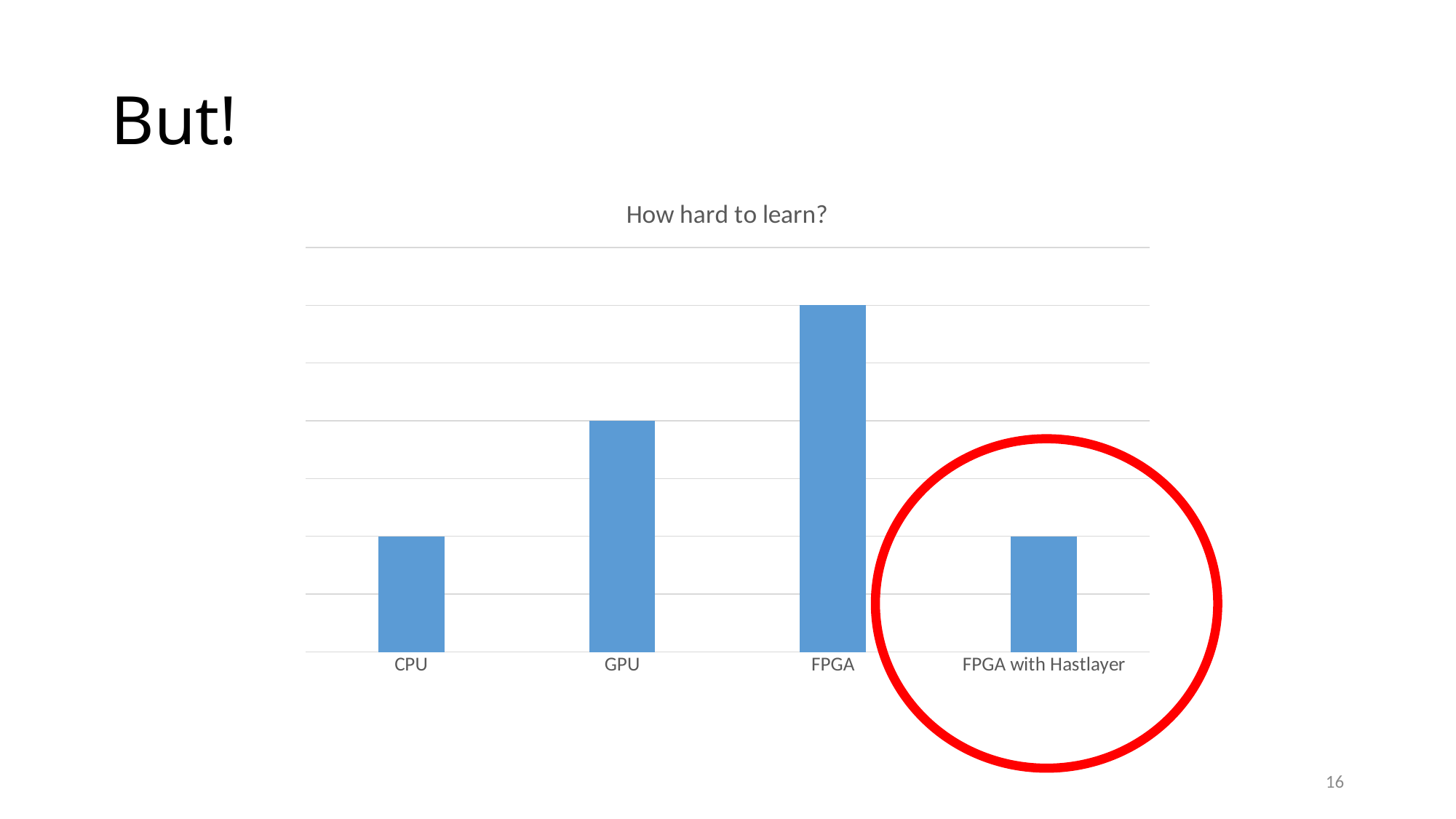
How many categories are shown on the x axis of the chart? 4 Which is larger, the bar for GPU or the bar for FPGA with Hastlayer? GPU What kind of chart is shown on the slide? bar chart Which is larger, the bar for GPU or the bar for CPU? GPU Which category on the chart is highlighted with a red circle? FPGA with Hastlayer Which is larger, the bar for FPGA or the bar for GPU? FPGA Which category has the highest bar in the chart? FPGA What is the label of the rightmost category on the x axis? FPGA with Hastlayer What is the title of the chart? How hard to learn?